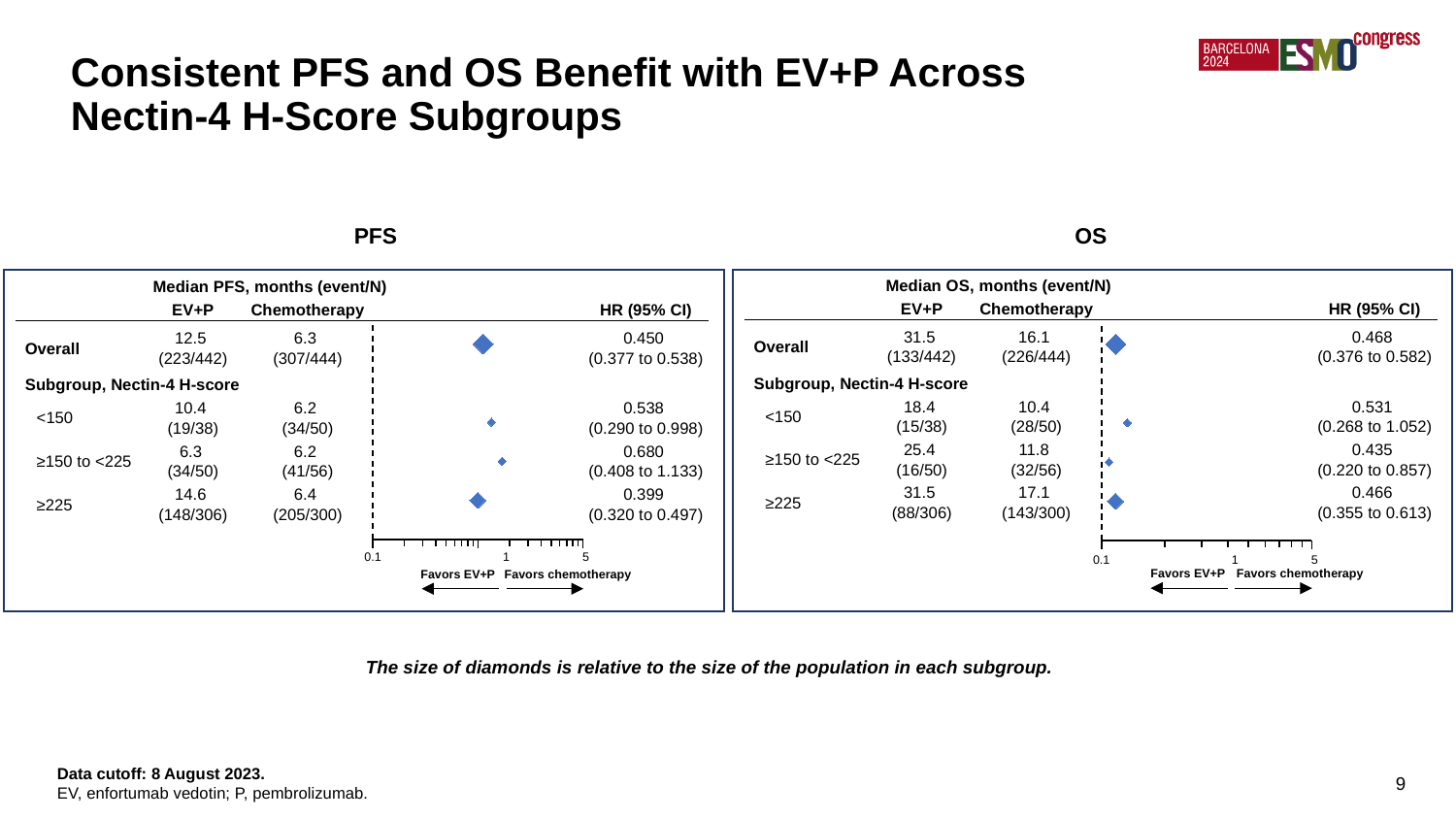
What kind of chart is used on this slide to display the hazard ratios? Forest plot How many Nectin-4 H-score subgroups are shown in the PFS forest plot? 3 In the OS forest plot, which Nectin-4 H-score subgroup has the lowest hazard ratio? ≥150 to <225 In the OS forest plot, what is the hazard ratio for the <150 subgroup? 0.531 In the PFS forest plot, what is the 95% CI for the hazard ratio in the ≥150 to <225 subgroup? 0.408 to 1.133 In the OS forest plot, which has the larger median OS in the <150 subgroup, EV+P or chemotherapy? EV+P In the PFS forest plot, which Nectin-4 H-score subgroup has the highest hazard ratio? ≥150 to <225 In the PFS forest plot, what is the hazard ratio for the Overall population? 0.450 In the PFS forest plot, which Nectin-4 H-score subgroup has the lowest hazard ratio? ≥225 In the OS forest plot, is the hazard ratio for the Overall population greater or less than 1? less In the OS forest plot, what is the median OS in months for EV+P in the ≥225 Nectin-4 H-score subgroup? 31.5 In the PFS forest plot, what is the difference in median PFS months between EV+P and chemotherapy in the ≥225 subgroup? 8.2